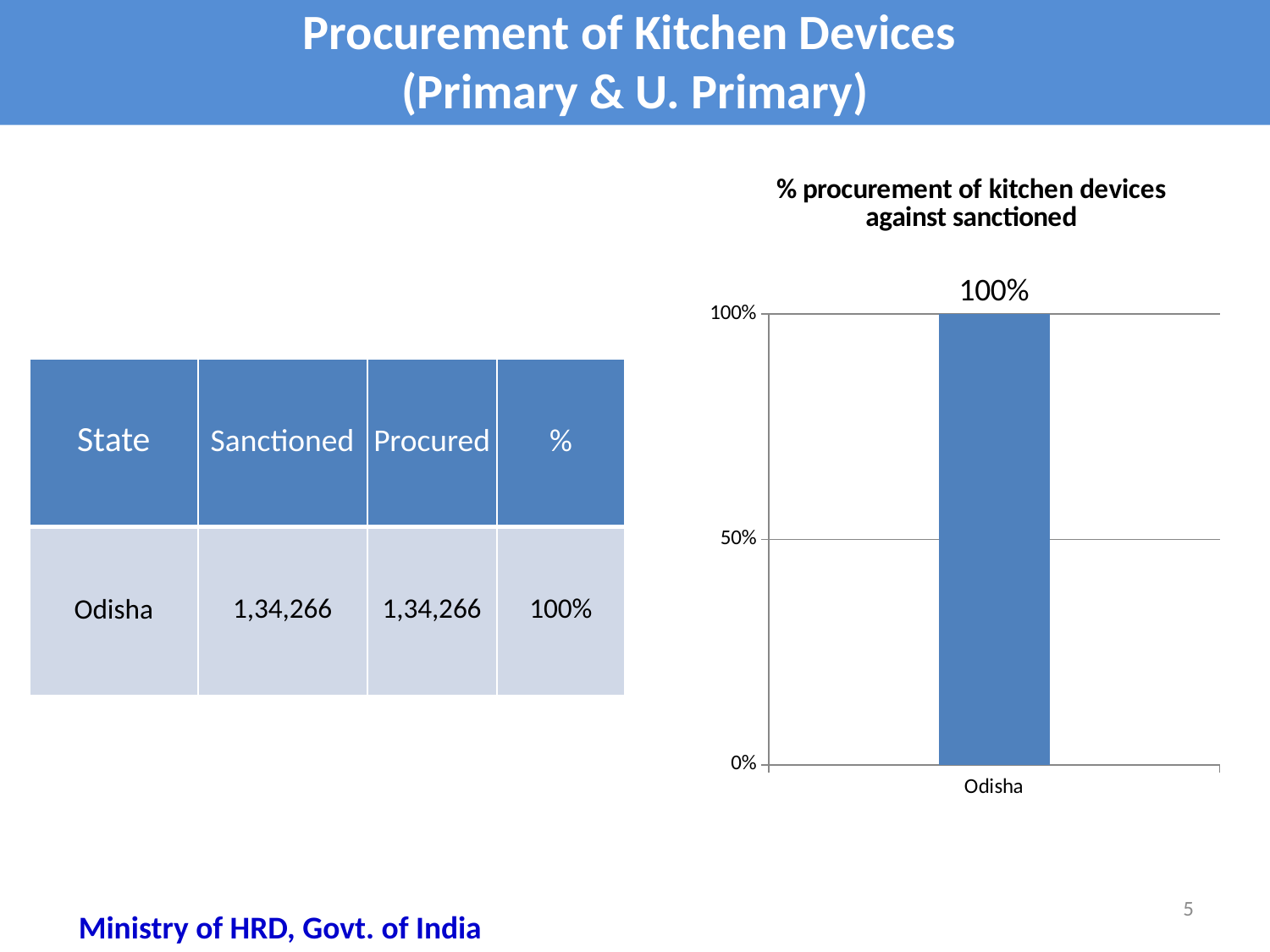
Which category is shown on the x axis of the chart? Odisha What is the value for Odisha in the chart? 100% How many categories are plotted in the chart? 1 What is the title of the chart? % procurement of kitchen devices against sanctioned What is the highest value shown on the y axis of the chart? 100% What kind of chart is shown on the slide? bar chart Is the value for Odisha greater or less than 50%? greater